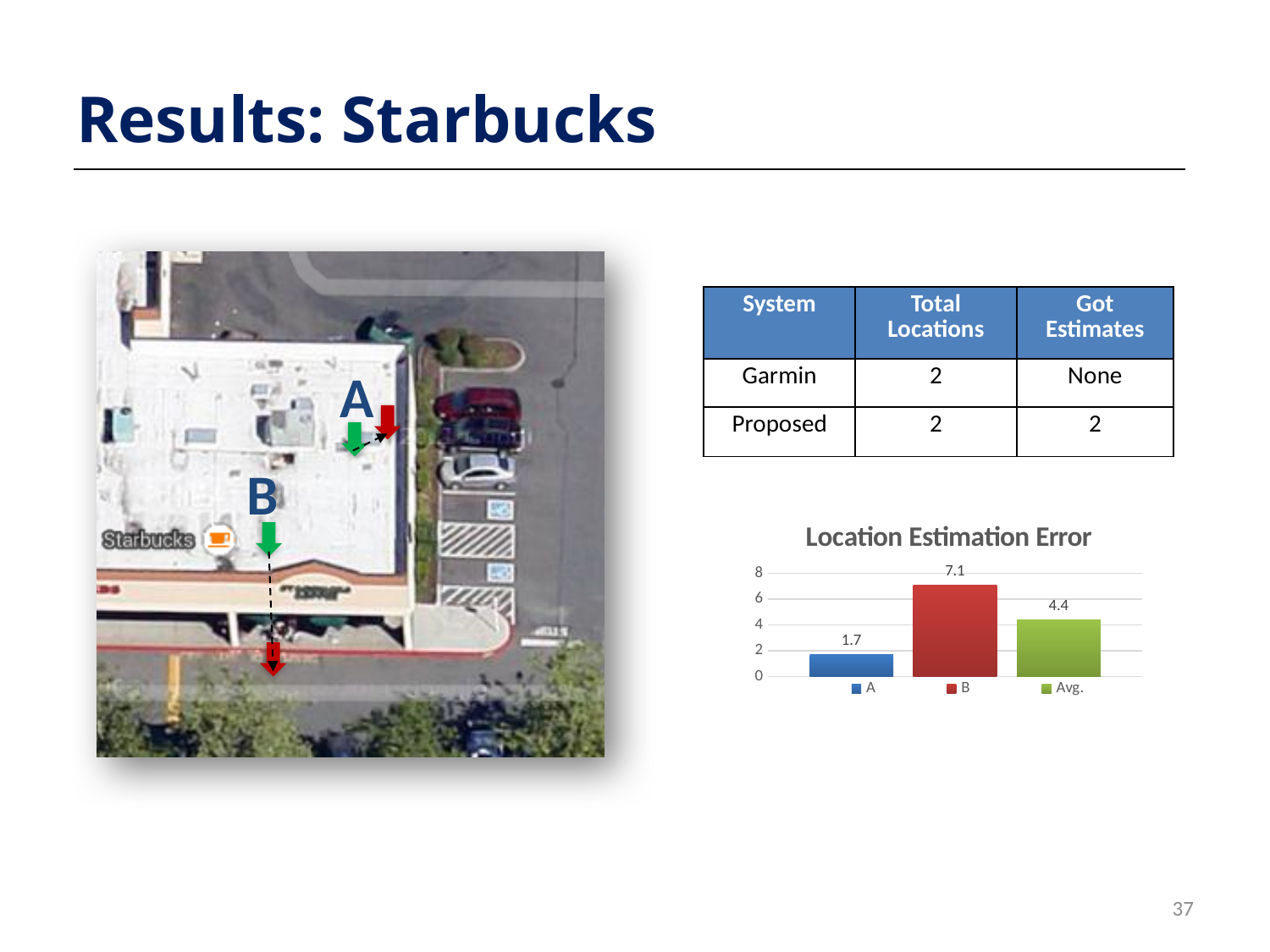
Which bar in the Location Estimation Error chart has the highest value? B Which bar in the Location Estimation Error chart has the lowest value? A What is the title of the chart on the slide? Location Estimation Error Which has a larger Location Estimation Error, A or Avg.? Avg. What is the Location Estimation Error value for B? 7.1 What kind of chart is the Location Estimation Error chart? bar chart How many entries does the legend of the Location Estimation Error chart list? 3 What is the difference between the Location Estimation Error values for B and A? 5.4 What is the Location Estimation Error value for A? 1.7 Is the Location Estimation Error value for B greater or less than 6? greater How many bars are plotted in the Location Estimation Error chart? 3 What is the Location Estimation Error value for Avg.? 4.4